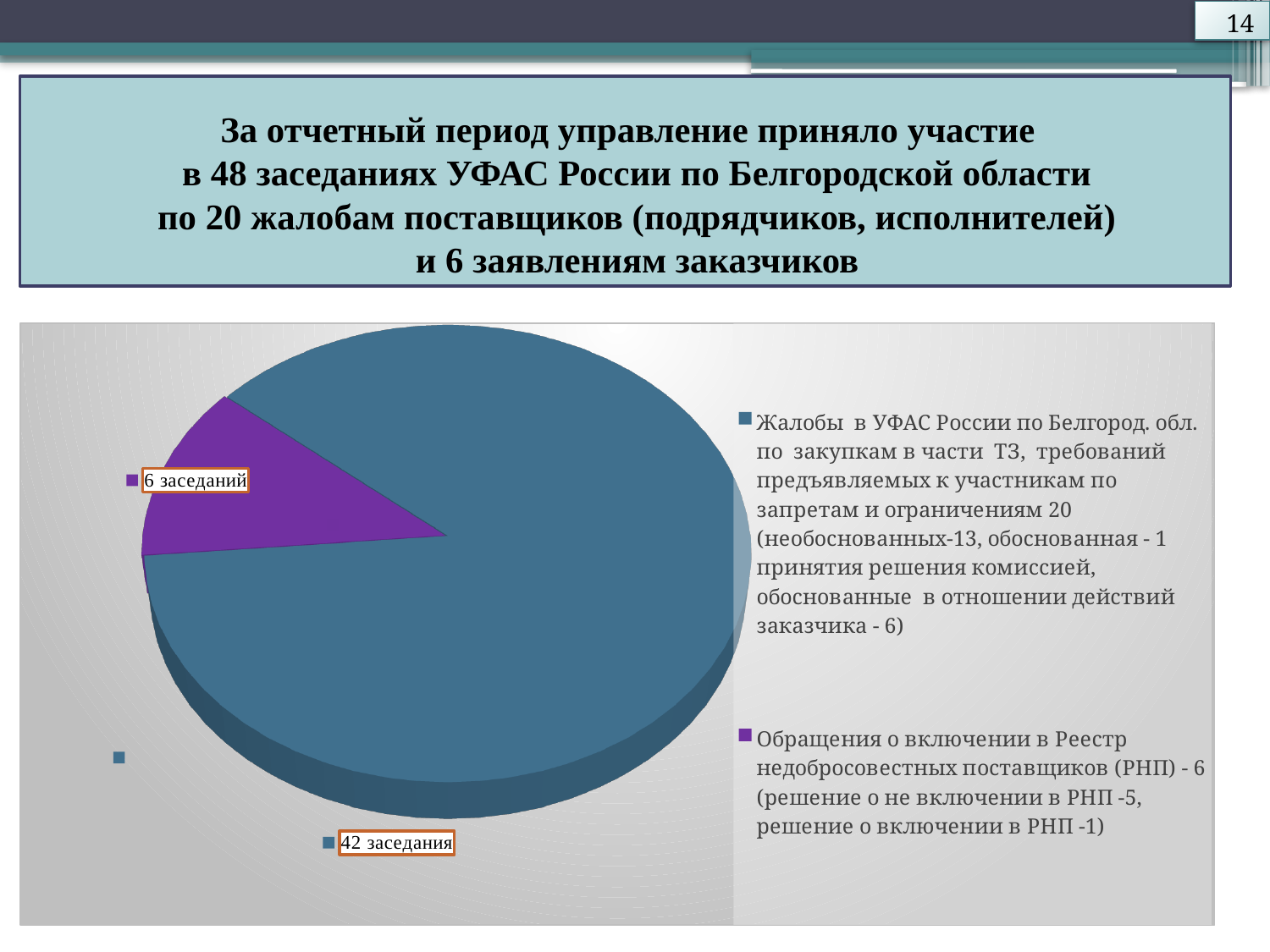
What kind of chart is shown on the slide? pie chart How many entries does the legend of the pie chart list? 2 What is the difference between the number of sessions in the blue slice and the purple slice? 36 Which slice of the pie chart is the largest? 42 заседания (Жалобы в УФАС России по Белгород. обл.) How many slices does the pie chart have? 2 What is the data label on the small purple slice of the pie chart? 6 заседаний What share of the pie does the purple slice (6 заседаний) represent? 12.5% What colour is the slice for 'Обращения о включении в Реестр недобросовестных поставщиков (РНП)'? purple Which slice of the pie chart is the smallest? 6 заседаний (Обращения о включении в Реестр недобросовестных поставщиков (РНП)) Which is larger: the blue slice (Жалобы в УФАС) or the purple slice (Обращения о включении в РНП)? the blue slice (Жалобы в УФАС) What is the data label on the large blue slice of the pie chart? 42 заседания What is the total number of sessions represented by the two slices of the pie chart? 48